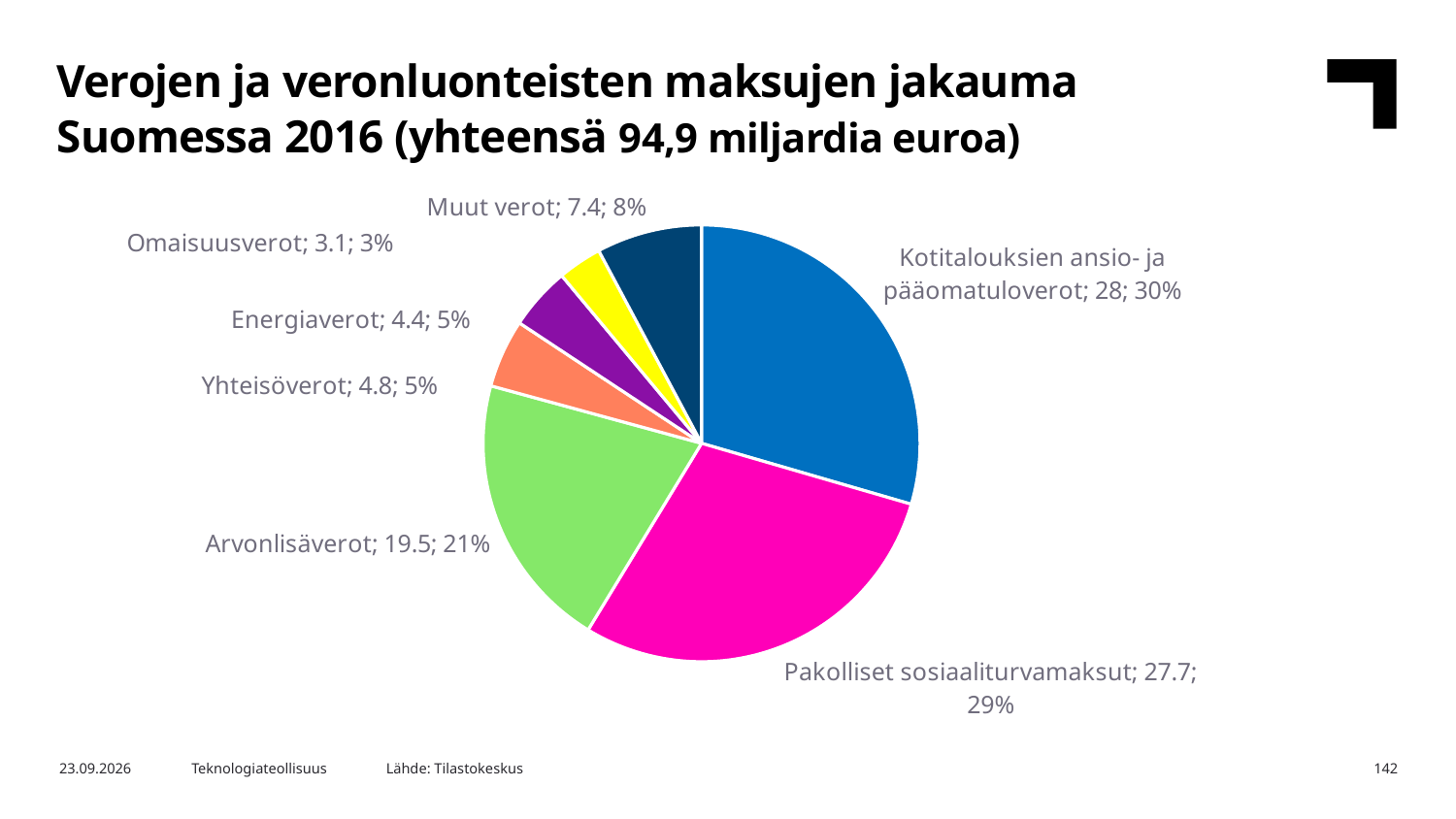
What value is shown for Pakolliset sosiaaliturvamaksut? 27.7 Which category has the largest slice of the pie? Kotitalouksien ansio- ja pääomatuloverot What kind of chart is shown on the slide? Pie chart What value is shown for Energiaverot? 4.4 What value is shown for Arvonlisäverot? 19.5 What value is shown for Muut verot? 7.4 How many slices does the pie chart have? 7 What share of the pie does Arvonlisäverot represent? 21% Which is larger, the value for Yhteisöverot or the value for Omaisuusverot? Yhteisöverot What is the difference between the values for Muut verot and Energiaverot? 3 Which category has the smallest slice of the pie? Omaisuusverot What is the difference between the values for Arvonlisäverot and Yhteisöverot? 14.7